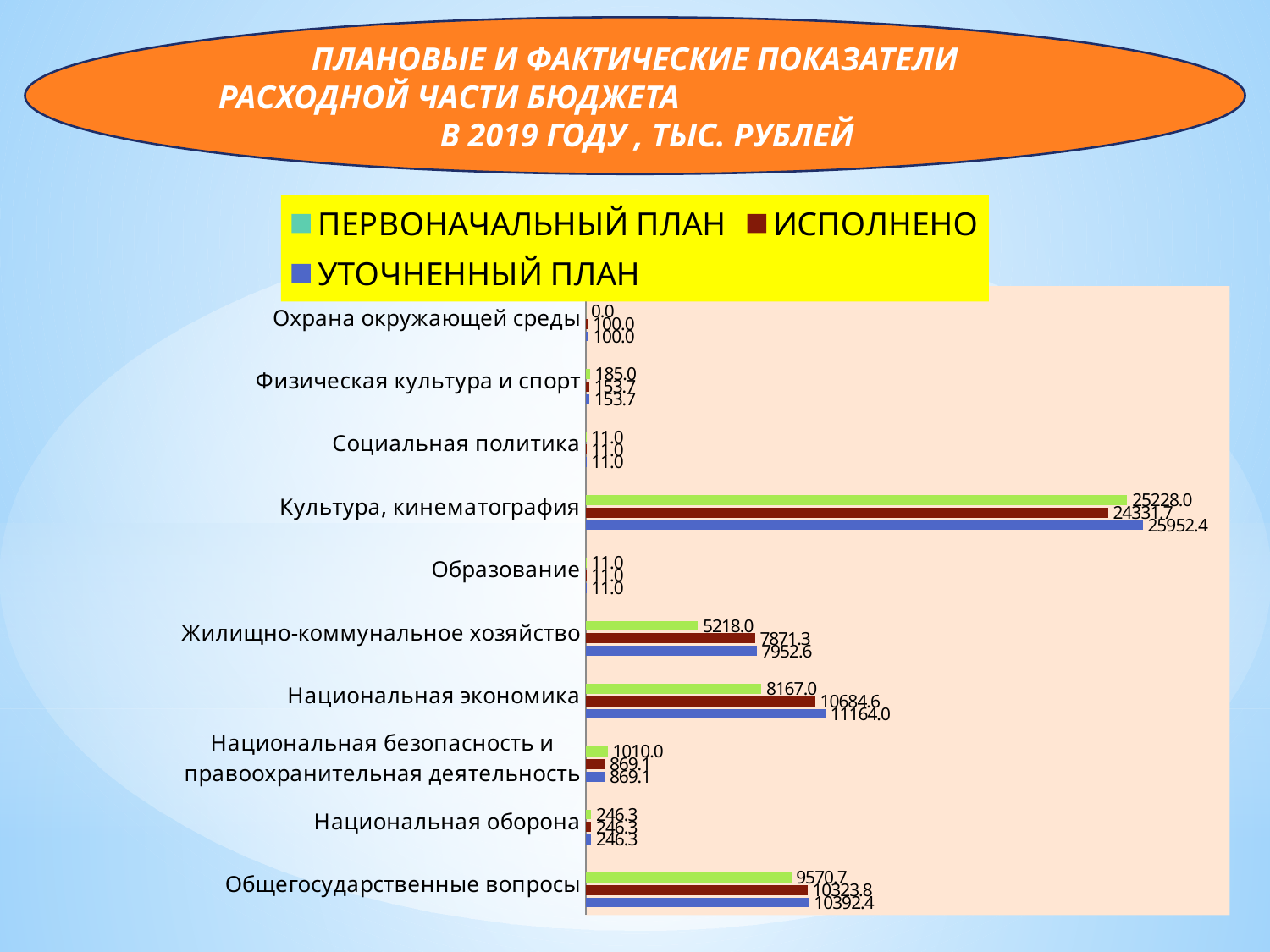
How many series does the legend list? 3 What kind of chart is shown on the slide? bar chart Which legend entry is shown in green? ПЕРВОНАЧАЛЬНЫЙ ПЛАН Which is larger for Общегосударственные вопросы: the ПЕРВОНАЧАЛЬНЫЙ ПЛАН value or the ИСПОЛНЕНО value? ИСПОЛНЕНО What is the difference between the УТОЧНЕННЫЙ ПЛАН and ПЕРВОНАЧАЛЬНЫЙ ПЛАН values for Национальная экономика? 2997.0 What is the ИСПОЛНЕНО value for Жилищно-коммунальное хозяйство? 7871.3 What is the ПЕРВОНАЧАЛЬНЫЙ ПЛАН value for Национальная безопасность и правоохранительная деятельность? 1010.0 What is the ПЕРВОНАЧАЛЬНЫЙ ПЛАН value for Жилищно-коммунальное хозяйство? 5218.0 What is the УТОЧНЕННЫЙ ПЛАН value for Национальная экономика? 11164.0 How many categories are shown on the chart? 10 Which category has the highest УТОЧНЕННЫЙ ПЛАН value? Культура, кинематография What is the ПЕРВОНАЧАЛЬНЫЙ ПЛАН value for Культура, кинематография? 25228.0